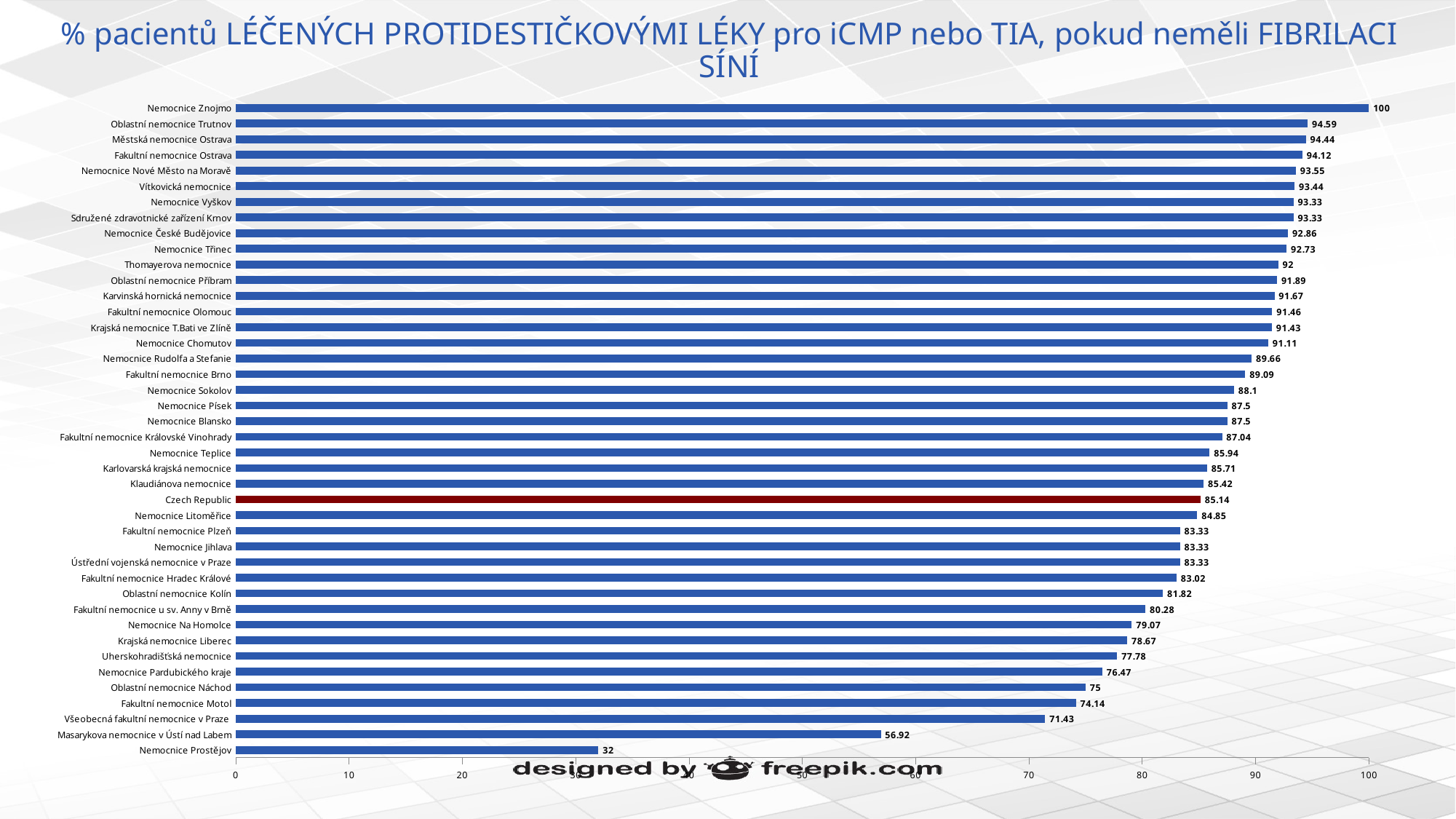
What is the value for Fakultní nemocnice Motol? 74.14 Which hospital has the lowest value? Nemocnice Prostějov What kind of chart is shown on the slide? bar chart Which is larger, the value for Fakultní nemocnice Brno or the value for Fakultní nemocnice Plzeň? Fakultní nemocnice Brno What is the value for Czech Republic? 85.14 What is the difference between the values for Czech Republic and Masarykova nemocnice v Ústí nad Labem? 28.22 What is the difference between the values for Nemocnice Znojmo and Nemocnice Prostějov? 68 Which hospital has the highest value? Nemocnice Znojmo Is the value for Oblastní nemocnice Náchod greater or less than 80? less Which bar is coloured dark red instead of blue? Czech Republic How many bars are plotted on the chart? 42 What is the value for Nemocnice Sokolov? 88.1